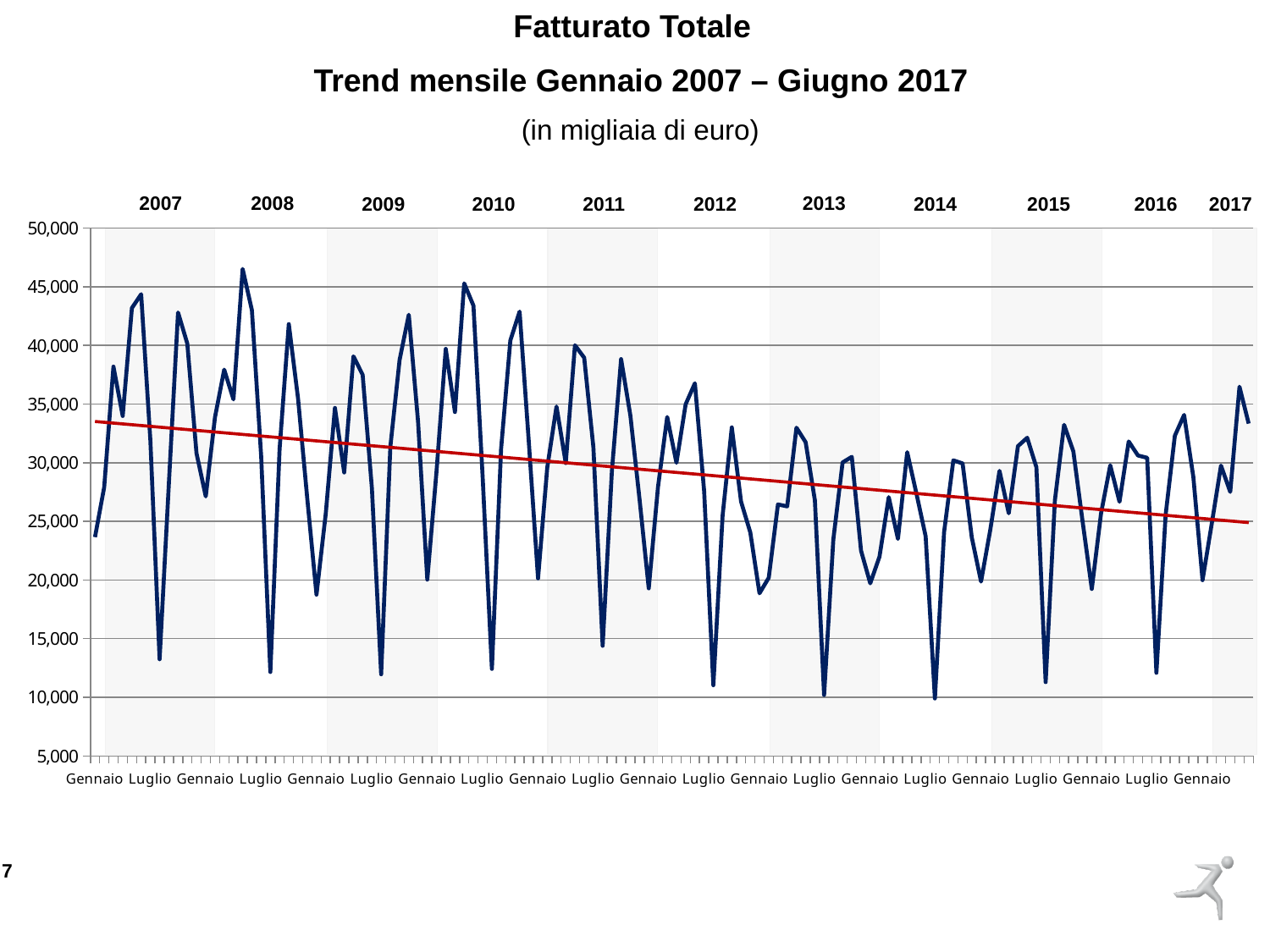
Which year contains the highest peak of the blue line, 2008 or 2015? 2008 Is the red trend line at the start of 2007 greater or less than 30,000? greater Is the value for Gennaio 2007 (the first point) greater or less than 25,000? less Is the highest peak in 2008 greater or less than 45,000? greater What is the title of the chart on the slide? Fatturato Totale How many year labels are shown along the top of the chart? 11 What kind of chart is shown on the slide? line chart In what unit are the values on the chart expressed, according to the subtitle? migliaia di euro Does the red trend line rise or fall from 2007 to 2017? fall